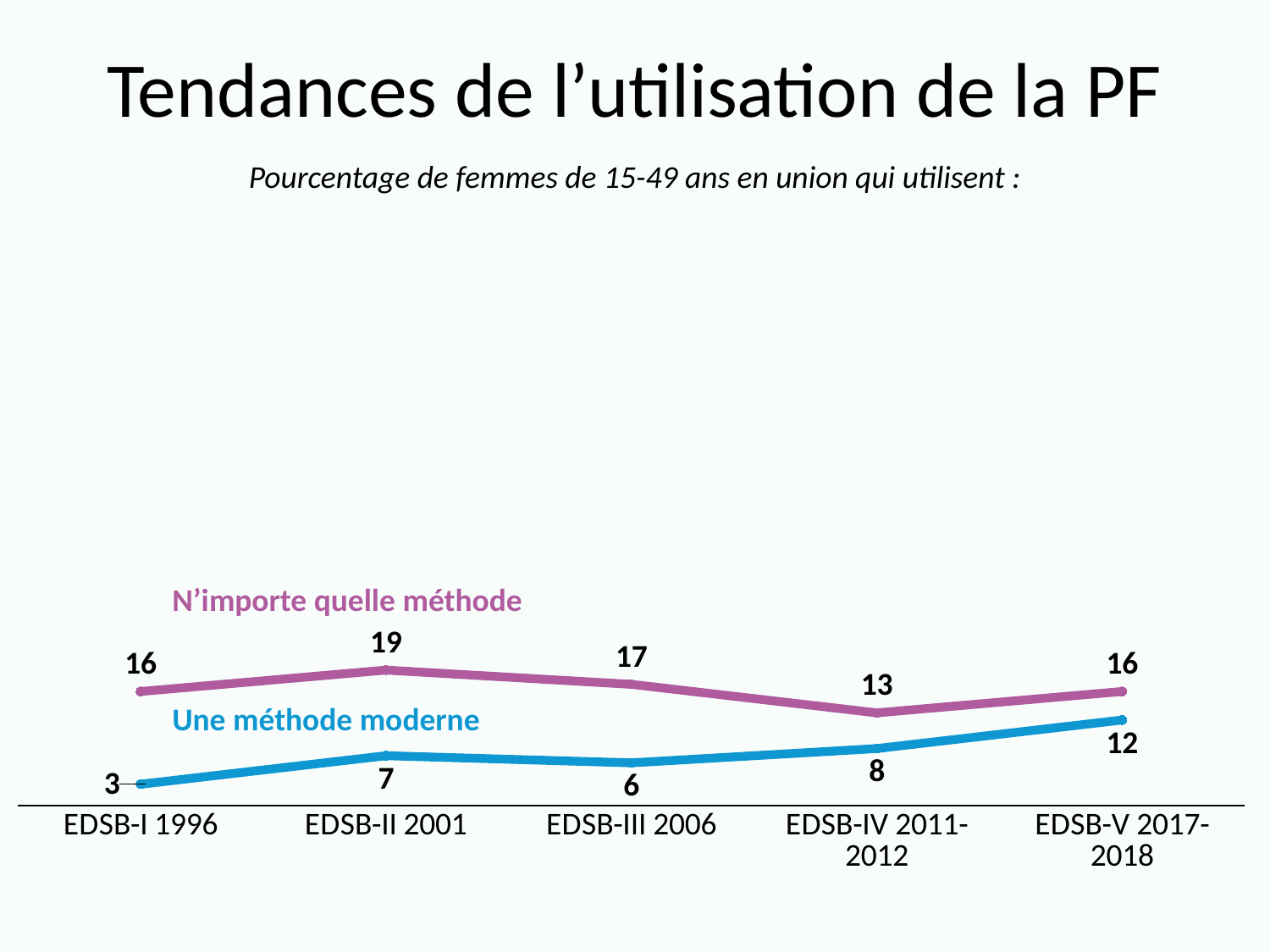
What is the value for "Une méthode moderne" at EDSB-V 2017-2018? 12 What is the value for "Une méthode moderne" at EDSB-I 1996? 3 What is the value for "N'importe quelle méthode" at EDSB-IV 2011-2012? 13 Which is larger at EDSB-V 2017-2018: "N'importe quelle méthode" or "Une méthode moderne"? N'importe quelle méthode How many series are plotted on the chart? 2 Does the value for "Une méthode moderne" rise or fall from EDSB-III 2006 to EDSB-V 2017-2018? Rise At which survey is the value for "Une méthode moderne" lowest? EDSB-I 1996 What is the value for "N'importe quelle méthode" at EDSB-II 2001? 19 What is the difference between "N'importe quelle méthode" and "Une méthode moderne" at EDSB-III 2006? 11 At which survey is the value for "N'importe quelle méthode" highest? EDSB-II 2001 What kind of chart is shown on the slide? Line chart How many survey points are plotted along the x axis? 5